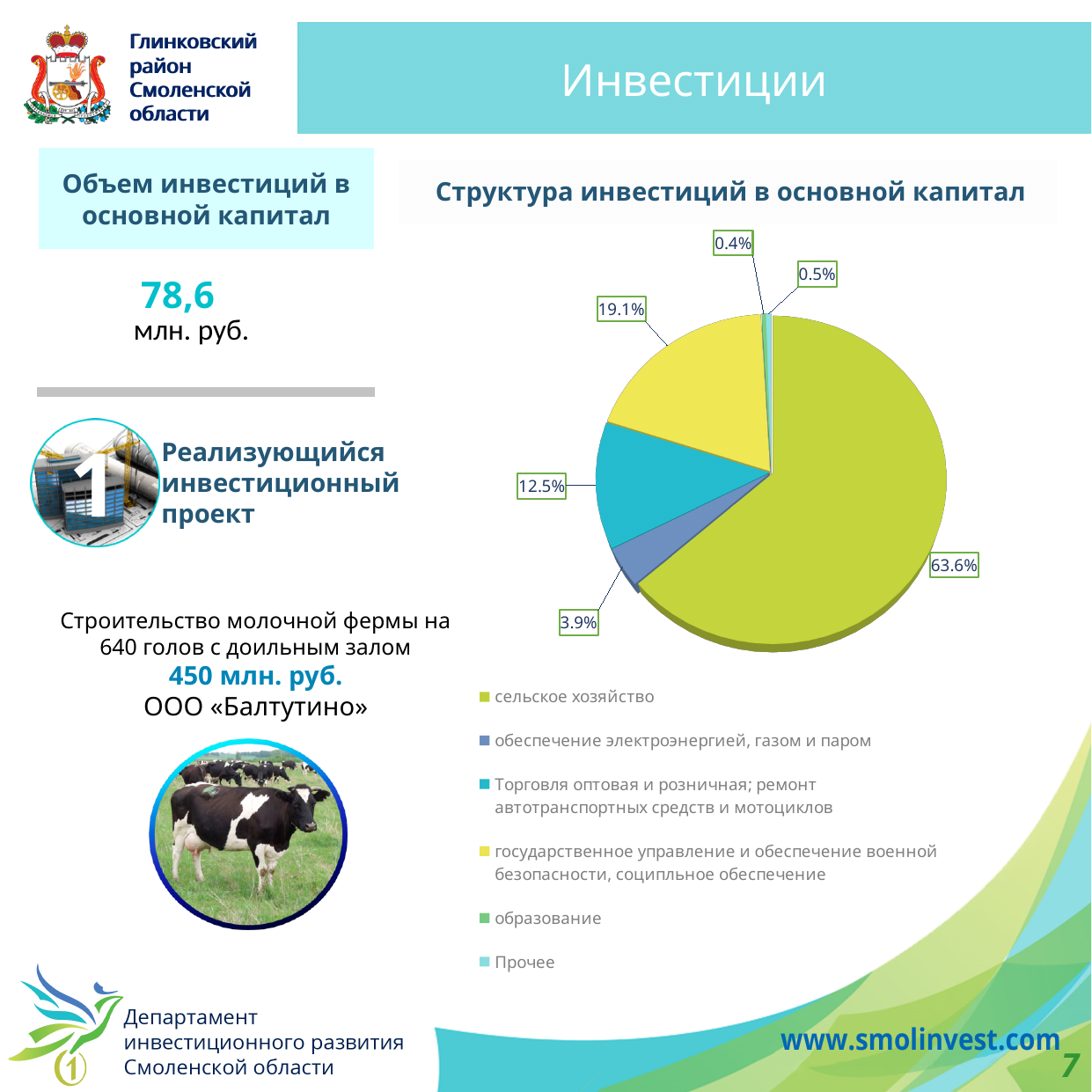
In the pie chart, which slice is larger: "Торговля оптовая и розничная; ремонт автотранспортных средств и мотоциклов" or "обеспечение электроэнергией, газом и паром"? Торговля оптовая и розничная; ремонт автотранспортных средств и мотоциклов What is the title of the pie chart on the slide? Структура инвестиций в основной капитал What kind of chart is shown under the title "Структура инвестиций в основной капитал"? pie chart In the pie chart, what share does "государственное управление и обеспечение военной безопасности, социальное обеспечение" have? 19.1% In the pie chart, what is the difference in percentage points between the "Торговля оптовая и розничная" slice and the "обеспечение электроэнергией, газом и паром" slice? 8.6 How many categories does the legend of the pie chart list? 6 In the pie chart, what share does "Торговля оптовая и розничная; ремонт автотранспортных средств и мотоциклов" have? 12.5% In the pie chart, what share does "обеспечение электроэнергией, газом и паром" have? 3.9% In the pie chart, what colour is the "сельское хозяйство" slice? yellow-green Which category has the largest slice in the pie chart "Структура инвестиций в основной капитал"? сельское хозяйство In the pie chart "Структура инвестиций в основной капитал", what share does "сельское хозяйство" have? 63.6% In the pie chart, what is the difference in percentage points between the "сельское хозяйство" slice and the "государственное управление и обеспечение военной безопасности, социальное обеспечение" slice? 44.5